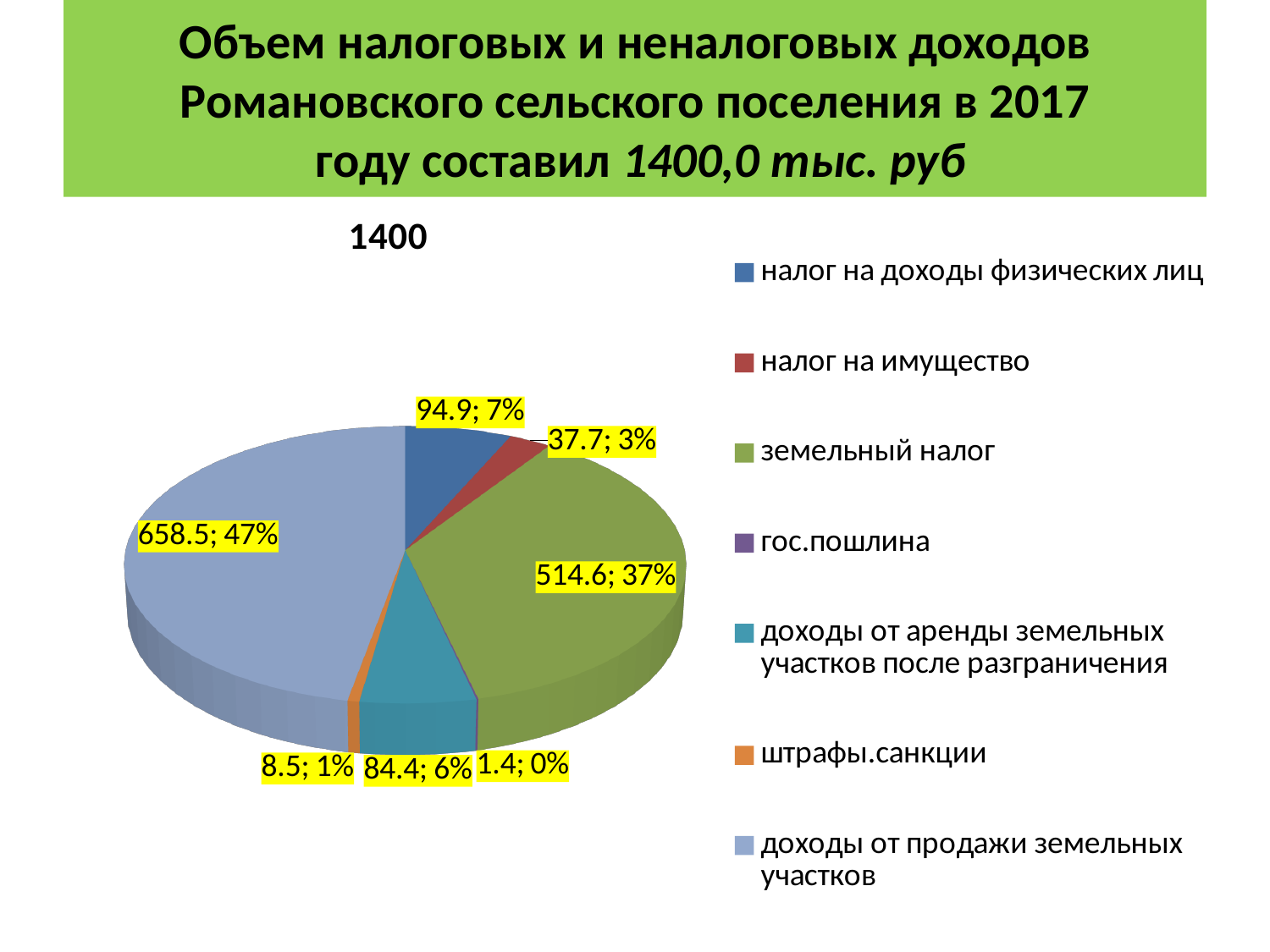
Which is larger, the value for налог на доходы физических лиц or the value for налог на имущество? налог на доходы физических лиц Which category has the largest slice of the pie? доходы от продажи земельных участков What is the value for земельный налог? 514.6 Which category has the smallest slice of the pie? гос.пошлина What share of the pie does налог на имущество represent? 3% What is the difference between the values for доходы от продажи земельных участков and земельный налог? 143.9 What is the value for доходы от аренды земельных участков после разграничения? 84.4 What kind of chart is shown on the slide? pie chart What is the value for налог на доходы физических лиц? 94.9 What is the value for штрафы.санкции? 8.5 What share of the pie does земельный налог represent? 37% How many categories does the legend list? 7